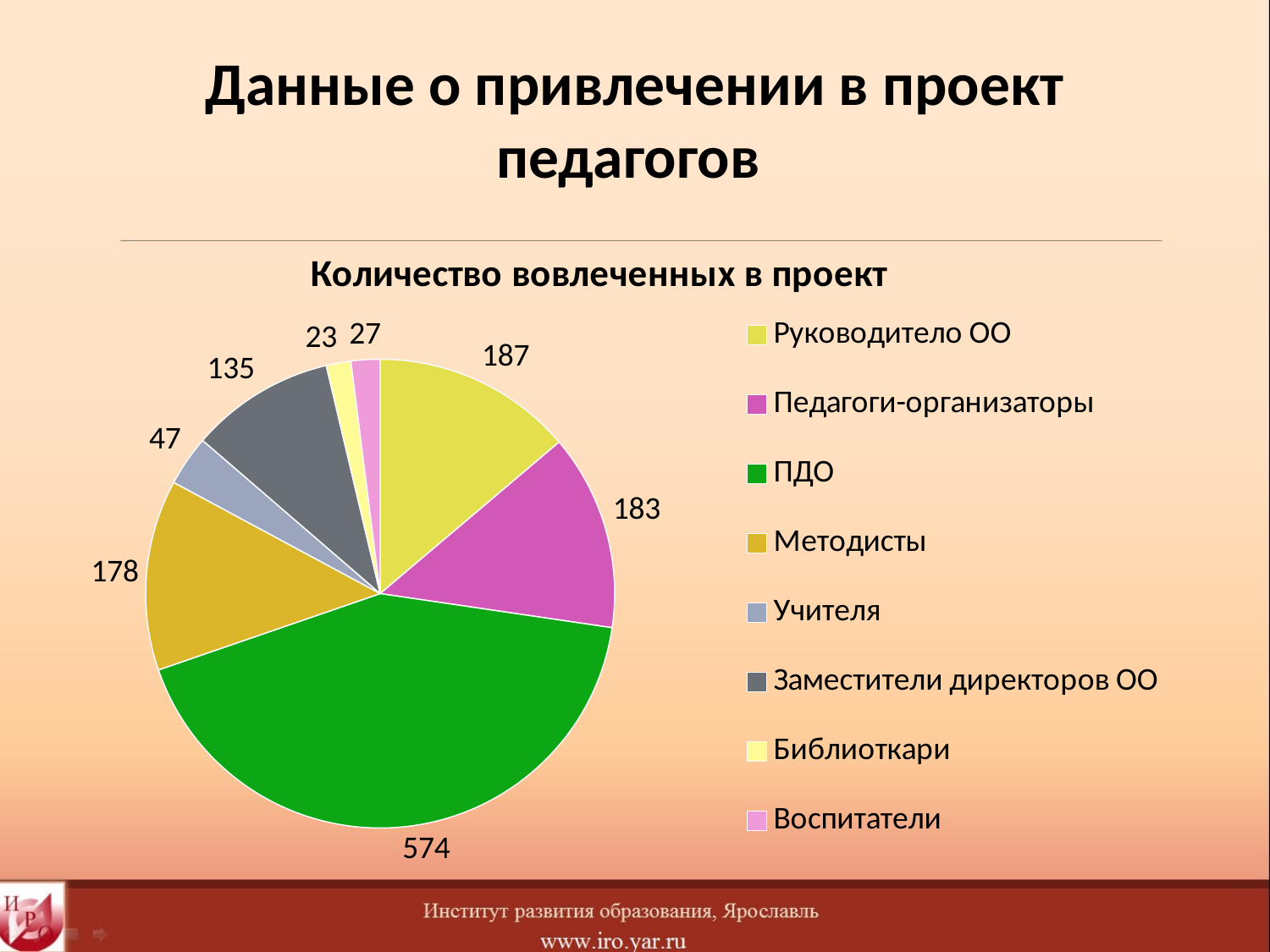
What is the value for Воспитатели? 27 Which category has the largest slice? ПДО What type of chart is shown on the slide? pie chart What is the value for Методисты? 178 What is the difference between the values for ПДО and Руководителo ОО? 387 What is the title of the chart? Количество вовлеченных в проект Which category has the smallest slice? Библиоткари Which is larger, the value for Учителя or the value for Заместители директоров ОО? Заместители директоров ОО How many categories does the legend list? 8 What is the value for Заместители директоров ОО? 135 What is the value for ПДО? 574 What is the total of all the slices in the pie? 1354